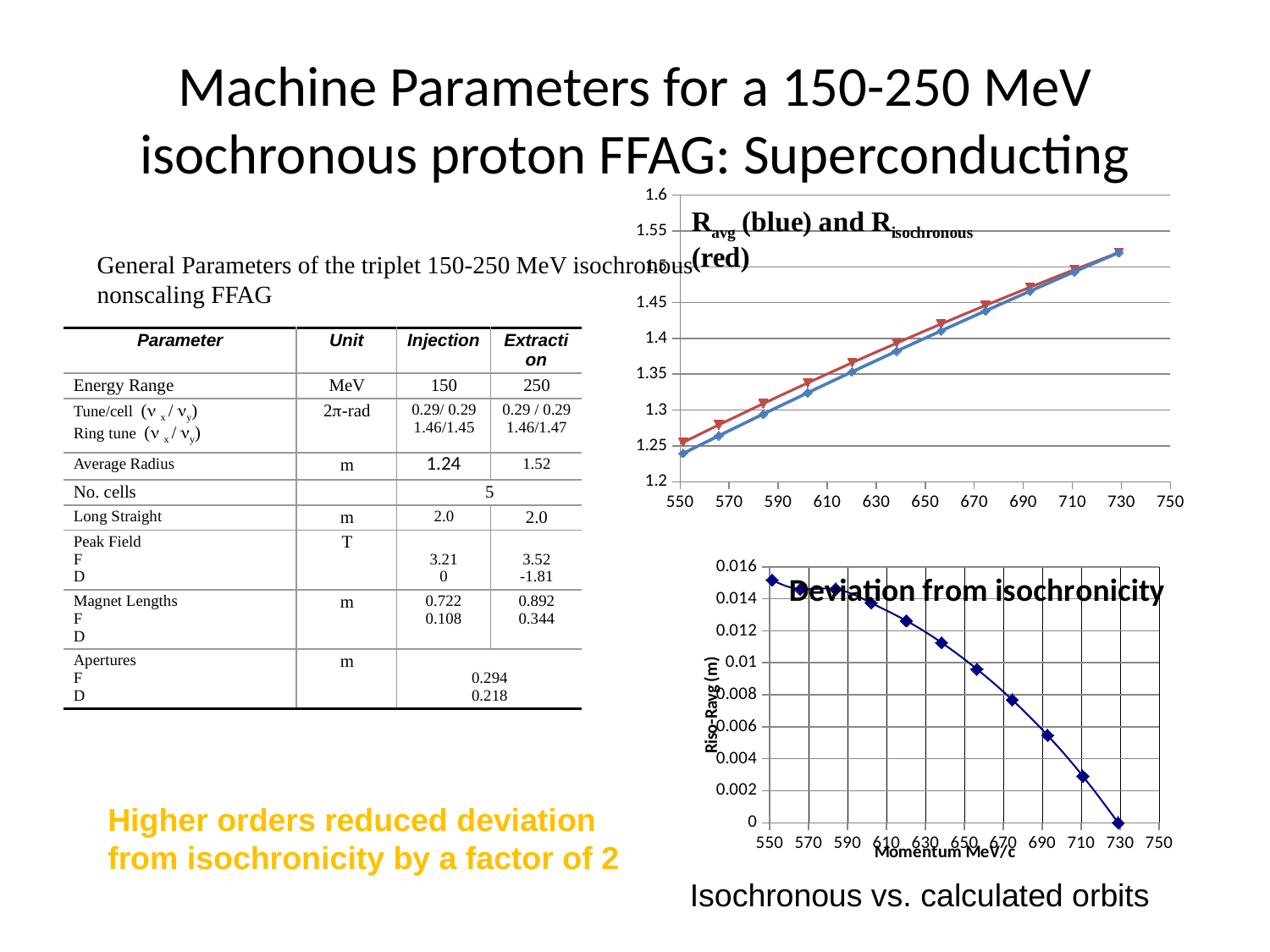
In the top-right chart 'Ravg (blue) and Risochronous (red)', at x = 610, which series has the larger value, the red or the blue? red In the 'Deviation from isochronicity' chart, do the values rise or fall as momentum increases along the x axis? fall What is the x-axis title of the 'Deviation from isochronicity' chart? Momentum MeV/c What is the y-axis title of the 'Deviation from isochronicity' chart? Riso-Ravg (m) In the 'Deviation from isochronicity' chart, is the value at 730 MeV/c greater or less than 0.002? less In the top-right chart 'Ravg (blue) and Risochronous (red)', is the red series value at 730 greater or less than 1.5? greater In the 'Deviation from isochronicity' chart, is the value at 690 MeV/c greater or less than 0.01? less What kind of chart is the 'Deviation from isochronicity' chart? line chart In the top-right chart 'Ravg (blue) and Risochronous (red)', do the blue series values rise or fall along the x axis? rise What kind of chart is the top-right chart titled 'Ravg (blue) and Risochronous (red)'? line chart